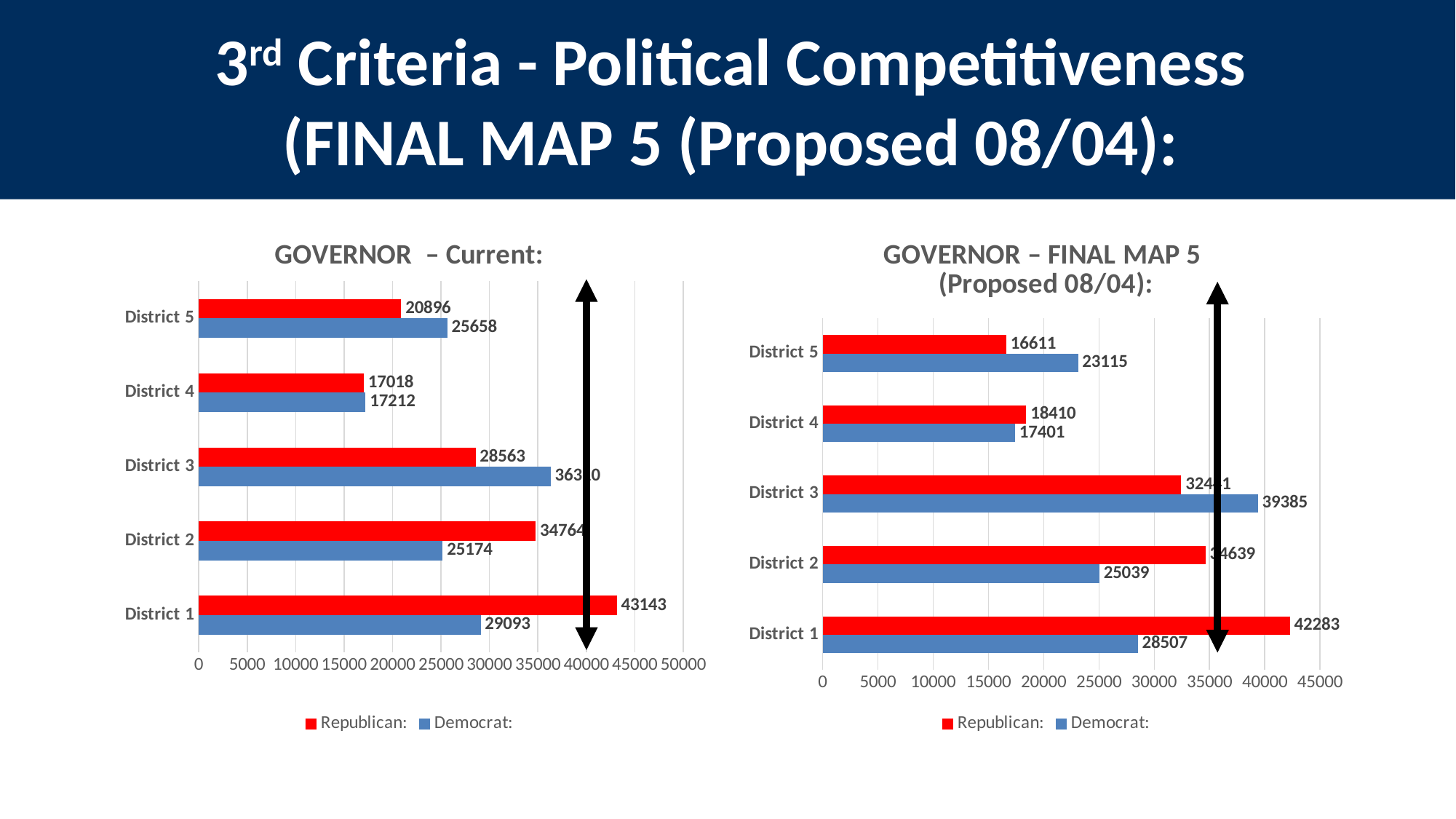
How many districts are shown in the GOVERNOR – Current chart? 5 In the GOVERNOR – Current chart, what is the difference between the Republican and Democrat values for District 1? 14050 In the GOVERNOR – Current chart, which district has the highest Republican value? District 1 In the GOVERNOR – FINAL MAP 5 chart, what is the Democrat value for District 3? 39385 In the GOVERNOR – Current chart, what is the Republican value for District 1? 43143 In the GOVERNOR – FINAL MAP 5 chart, what is the difference between the Democrat and Republican values for District 5? 6504 In the GOVERNOR – FINAL MAP 5 chart, is the Republican or Democrat value larger for District 4? Republican In the GOVERNOR – FINAL MAP 5 chart, which district has the lowest Democrat value? District 4 In the GOVERNOR – Current chart, what is the Democrat value for District 5? 25658 In the GOVERNOR – Current chart, is the Democrat value for District 3 greater or less than 30000? greater In the GOVERNOR – FINAL MAP 5 chart, what is the Republican value for District 5? 16611 What kind of chart is the GOVERNOR – FINAL MAP 5 chart? Bar chart